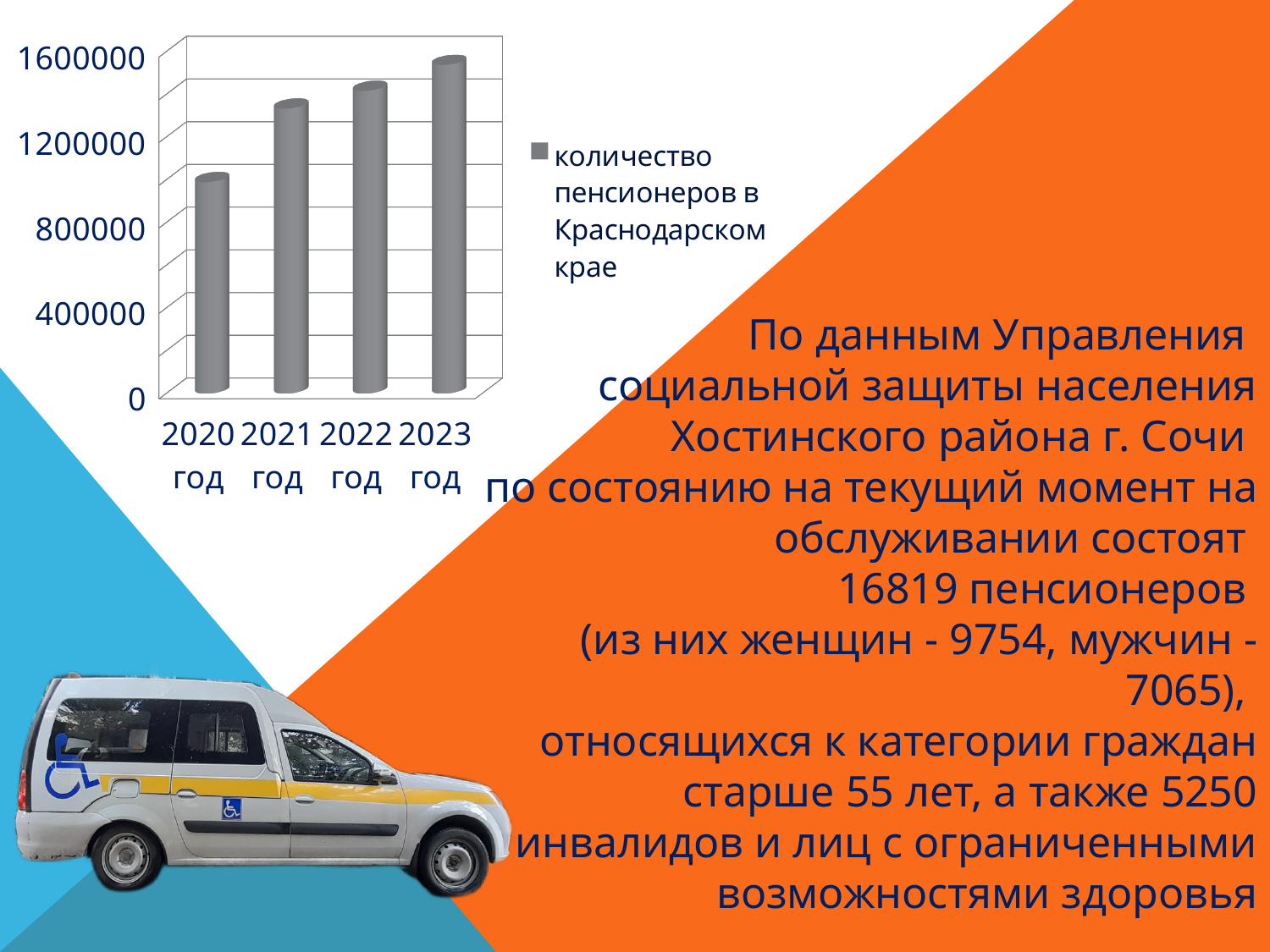
Which year has the highest number of pensioners in the chart? 2023 год Do the values in the chart rise or fall from 2020 to 2023? rise How many series does the chart legend list? 1 What kind of chart is shown on the slide? bar chart Is the value for 2020 год greater or less than 800000? greater Is the value for 2020 год greater or less than 1200000? less How many years (categories) are shown on the x axis of the chart? 4 Is the value for 2023 год greater or less than 1600000? less Which year has the lowest number of pensioners in the chart? 2020 год What is the name of the series shown in the chart legend? количество пенсионеров в Краснодарском крае Which is larger in the chart: the value for 2020 год or the value for 2023 год? 2023 год